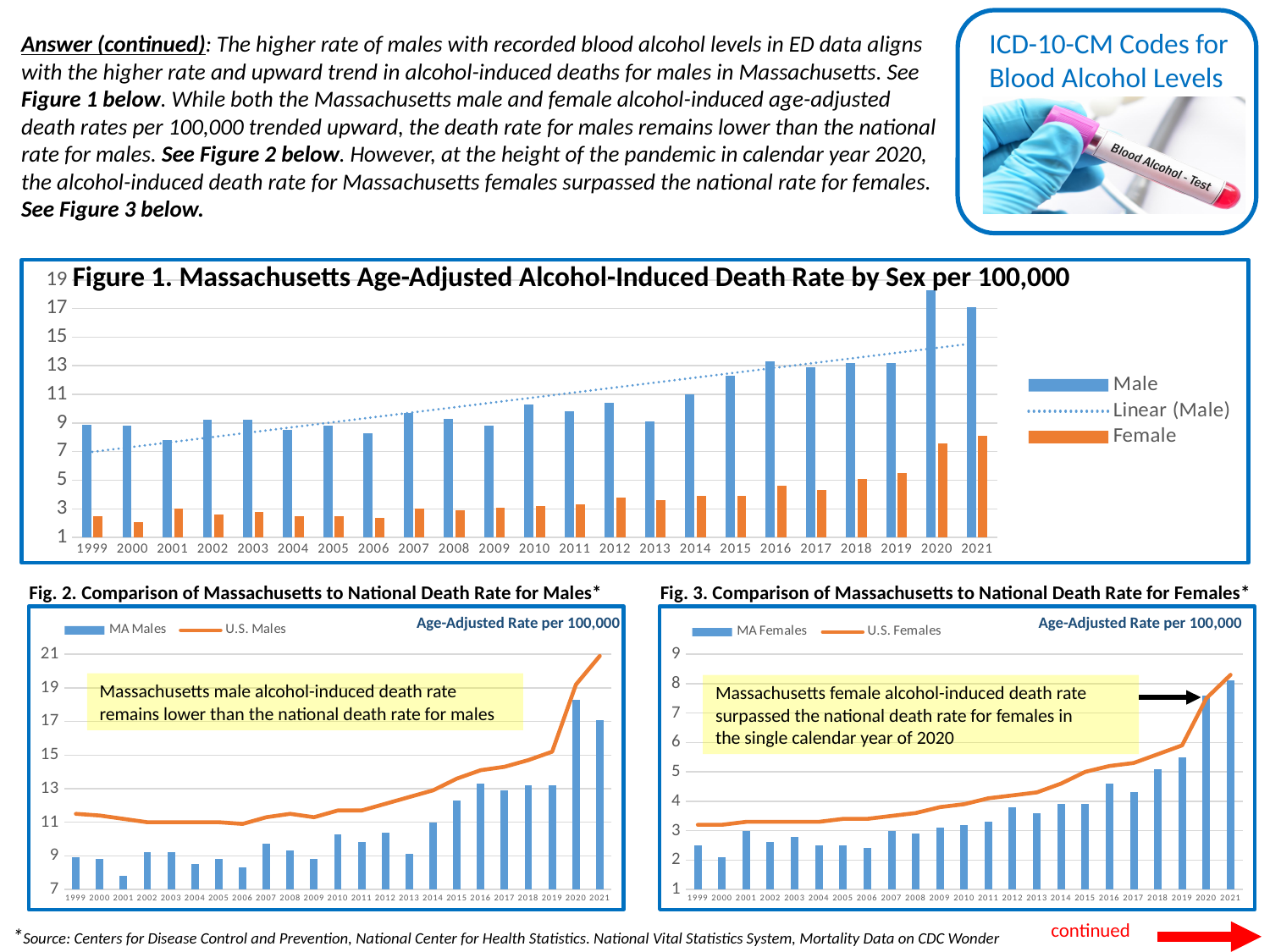
In Figure 1, which year has the lowest Female death rate? 2000 In Figure 1, which year has the highest Male death rate? 2020 In Fig. 2 (Comparison of Massachusetts to National Death Rate for Males), is the U.S. Males value for 2021 greater or less than 19? greater In Figure 1, is the Male value for 2020 greater or less than 17? greater In Figure 1, is the Female value for 1999 greater or less than 3? less In Fig. 2 (Comparison of Massachusetts to National Death Rate for Males), do the U.S. Males values generally rise or fall from 1999 to 2021? Rise In Figure 1, how many entries does the legend list? 3 In Figure 1, which colour represents the Female series? Orange What kind of chart is Figure 1 (Massachusetts Age-Adjusted Alcohol-Induced Death Rate by Sex per 100,000)? Bar chart In Figure 1, how many years are shown on the x axis? 23 In Fig. 3 (Comparison of Massachusetts to National Death Rate for Females), which year has the lowest MA Females value? 2000 In Fig. 3 (Comparison of Massachusetts to National Death Rate for Females), which is larger in 2020: MA Females or U.S. Females? MA Females